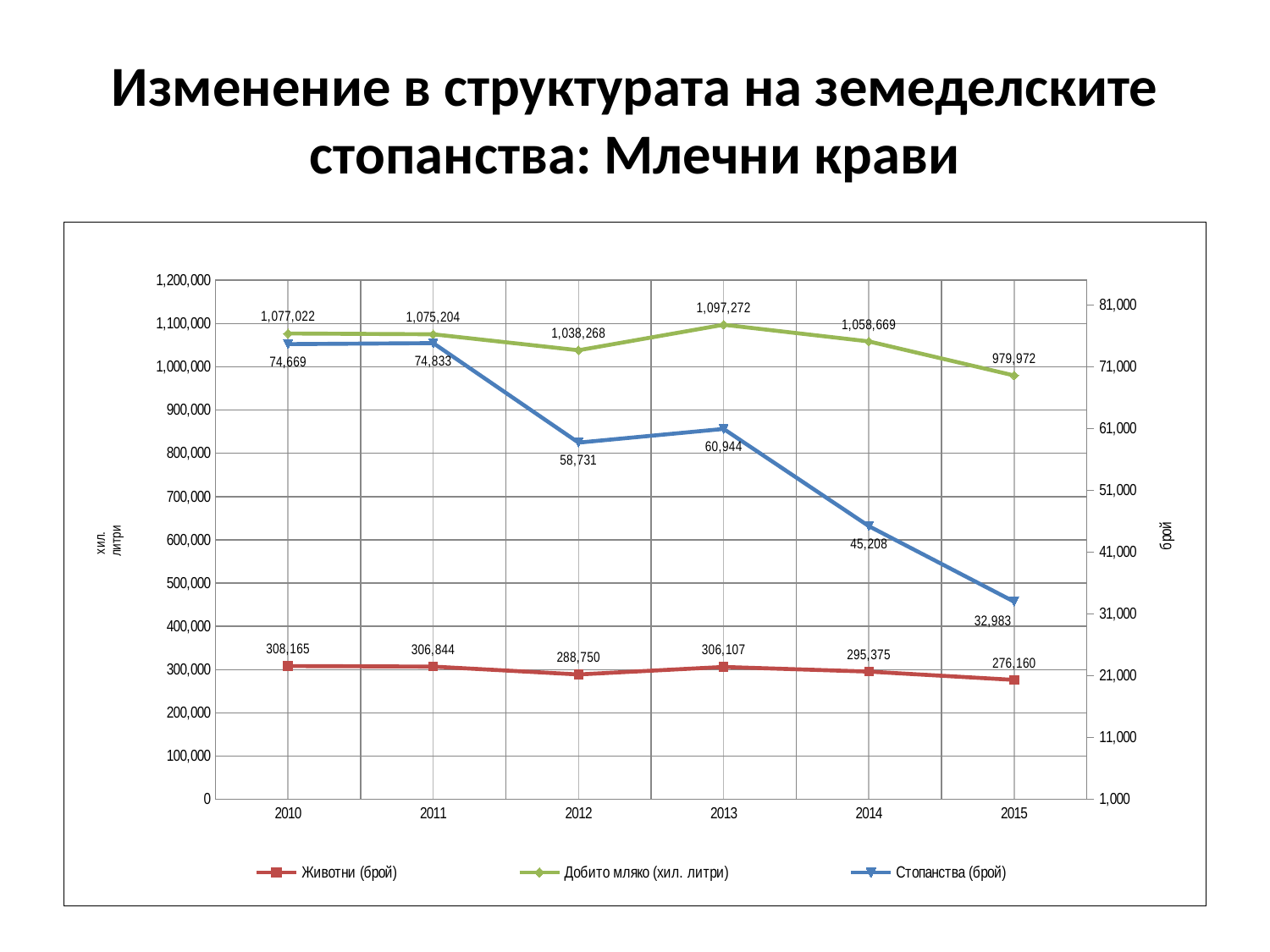
What is the difference between the Стопанства (брой) values for 2010 and 2015? 41,686 How many series does the legend list? 3 Does the Стопанства (брой) series rise or fall from 2011 to 2015? fall Which is larger, the Животни (брой) value for 2010 or for 2015? 2010 What is the value of Добито мляко (хил. литри) in 2013? 1,097,272 What is the value of Стопанства (брой) in 2015? 32,983 In which year is Добито мляко (хил. литри) highest? 2013 What is the title of the slide? Изменение в структурата на земеделските стопанства: Млечни крави What is the value of Животни (брой) in 2012? 288,750 What kind of chart is shown on the slide? line chart How many years are plotted along the x axis? 6 In which year is Стопанства (брой) lowest? 2015